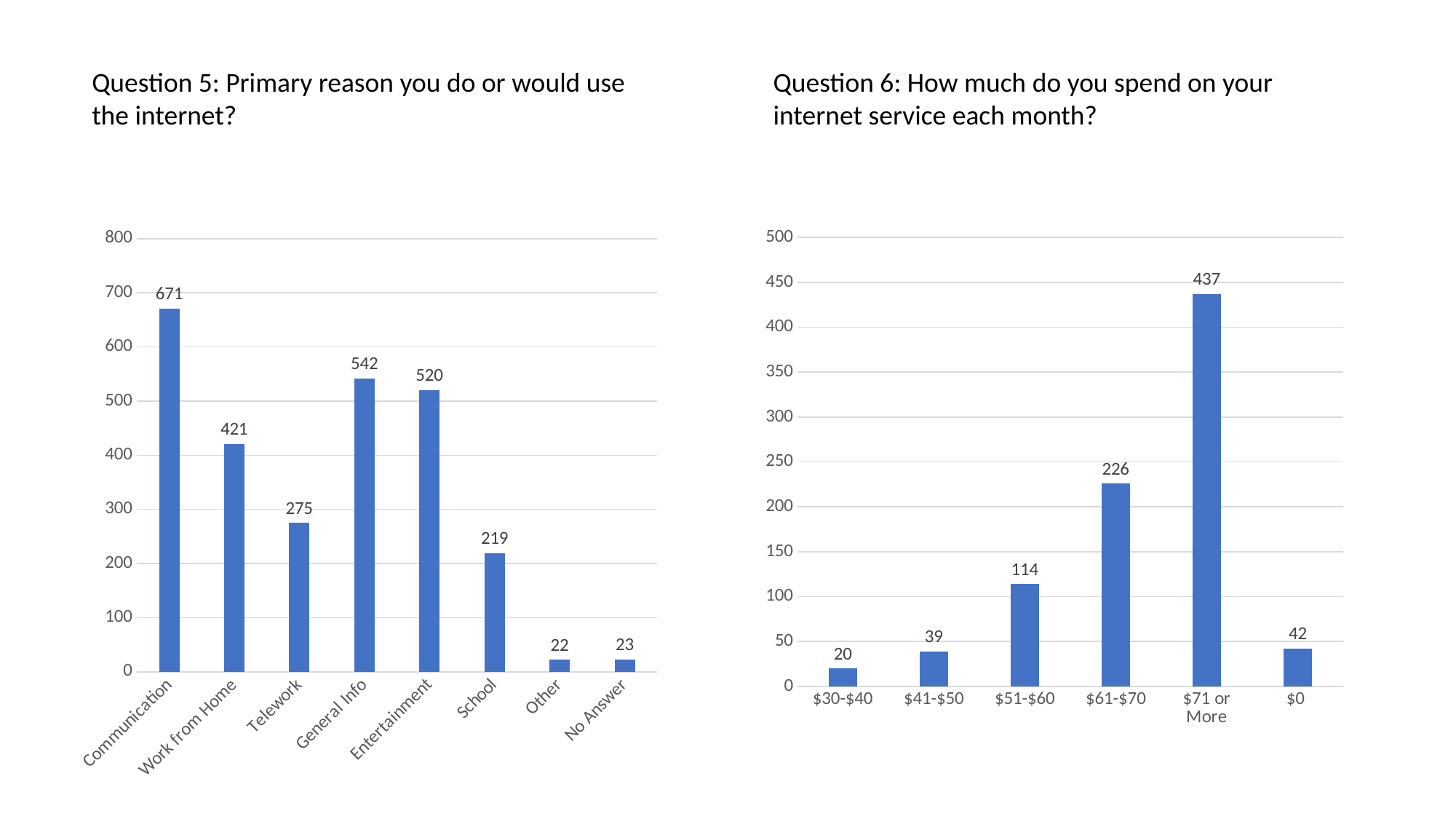
In the Question 6 chart (right), how many categories are shown? 6 In the Question 6 chart (right), what is the value for $61-$70? 226 In the Question 5 chart (left), which category has the highest value? Communication In the Question 5 chart (left), how many categories are shown? 8 In the Question 6 chart (right), what is the difference between $71 or More and $61-$70? 211 What type of chart is the Question 6 chart (right)? Bar chart In the Question 5 chart (left), which category has the lowest value? Other In the Question 5 chart (left), what is the value for Communication? 671 In the Question 5 chart (left), what is the difference between General Info and Entertainment? 22 In the Question 6 chart (right), which category has the lowest value? $30-$40 In the Question 5 chart (left), which is larger, Work from Home or Telework? Work from Home In the Question 6 chart (right), which category has the highest value? $71 or More